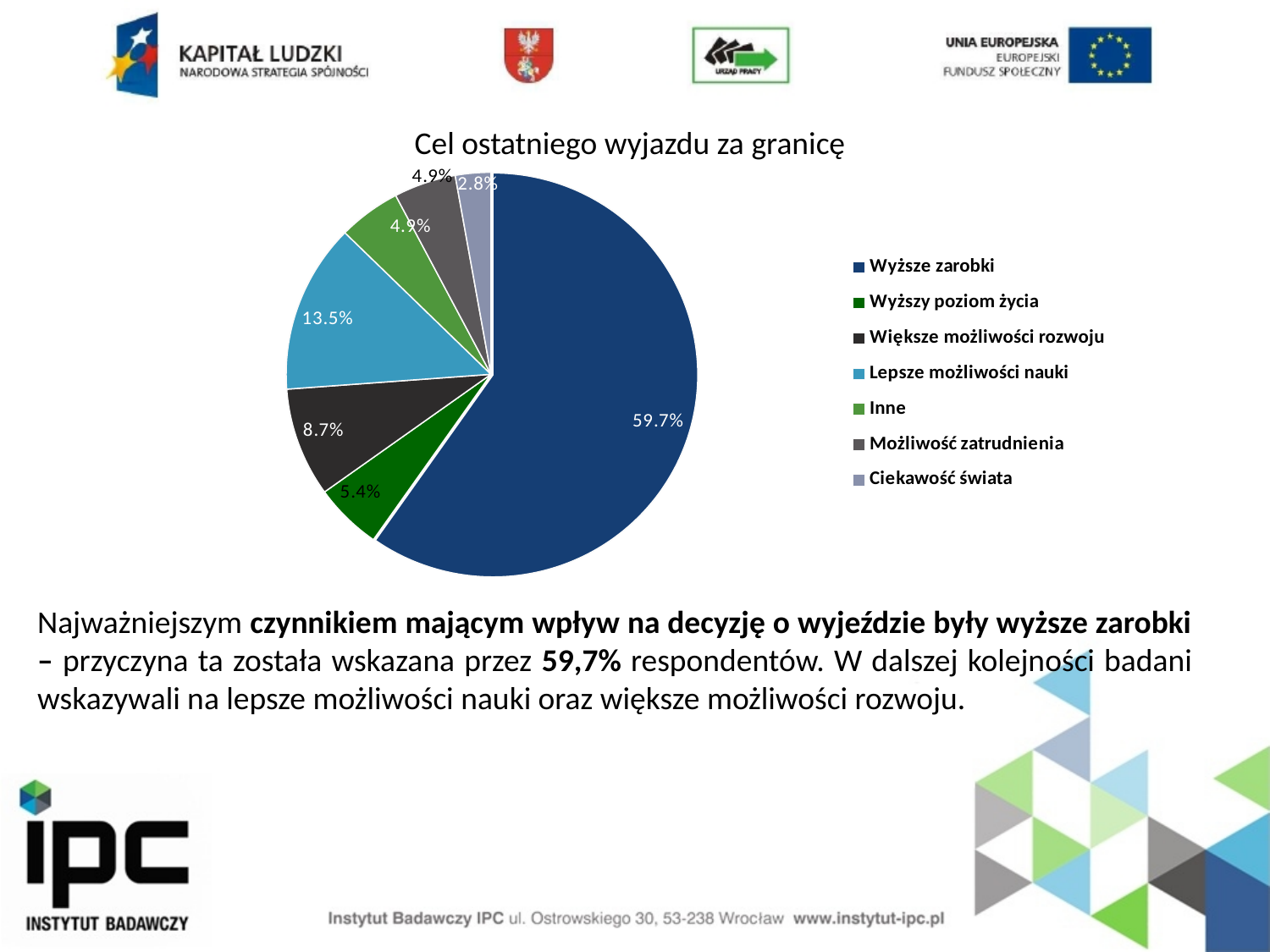
What percentage is shown for Wyższy poziom życia? 5.4% What percentage is shown for Większe możliwości rozwoju? 8.7% What percentage is shown for Lepsze możliwości nauki? 13.5% What percentage of the pie is the slice for Wyższe zarobki? 59.7% What is the title of the chart? Cel ostatniego wyjazdu za granicę Which is larger: the slice for Większe możliwości rozwoju or the slice for Wyższy poziom życia? Większe możliwości rozwoju Which category has the largest slice of the pie? Wyższe zarobki What is the difference in percentage points between Wyższe zarobki and Lepsze możliwości nauki? 46.2 What type of chart is shown on the slide? pie chart Which category has the smallest slice of the pie? Ciekawość świata How many categories does the legend list? 7 What percentage is shown for Ciekawość świata? 2.8%